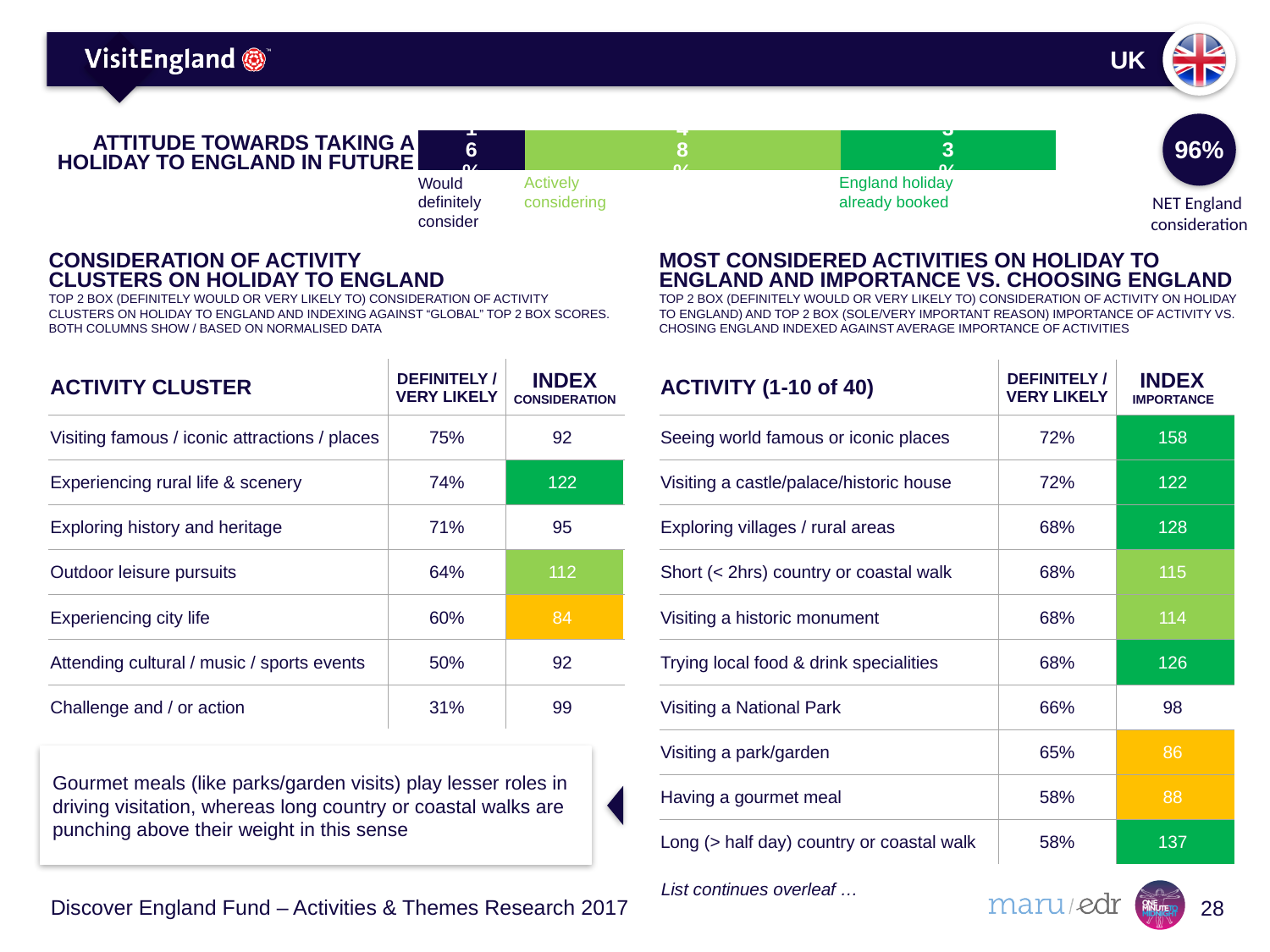
In the 'Attitude towards taking a holiday to England in future' chart, which segment is shown in light green? Actively considering In the 'Attitude towards taking a holiday to England in future' chart, what colour is the 'Would definitely consider' segment? Dark navy blue In the 'Attitude towards taking a holiday to England in future' chart, which segment is larger: 'Actively considering' or 'England holiday already booked'? Actively considering In the 'Attitude towards taking a holiday to England in future' chart, which segment is larger: 'England holiday already booked' or 'Would definitely consider'? England holiday already booked In the 'Attitude towards taking a holiday to England in future' chart, which segment is the smallest? Would definitely consider In the 'Attitude towards taking a holiday to England in future' chart, which segment is the largest? Actively considering What NET England consideration figure is shown in the circle next to the 'Attitude towards taking a holiday to England in future' chart? 96% What kind of chart is shown under the heading 'Attitude towards taking a holiday to England in future'? Stacked bar chart How many segments make up the 'Attitude towards taking a holiday to England in future' bar? 3